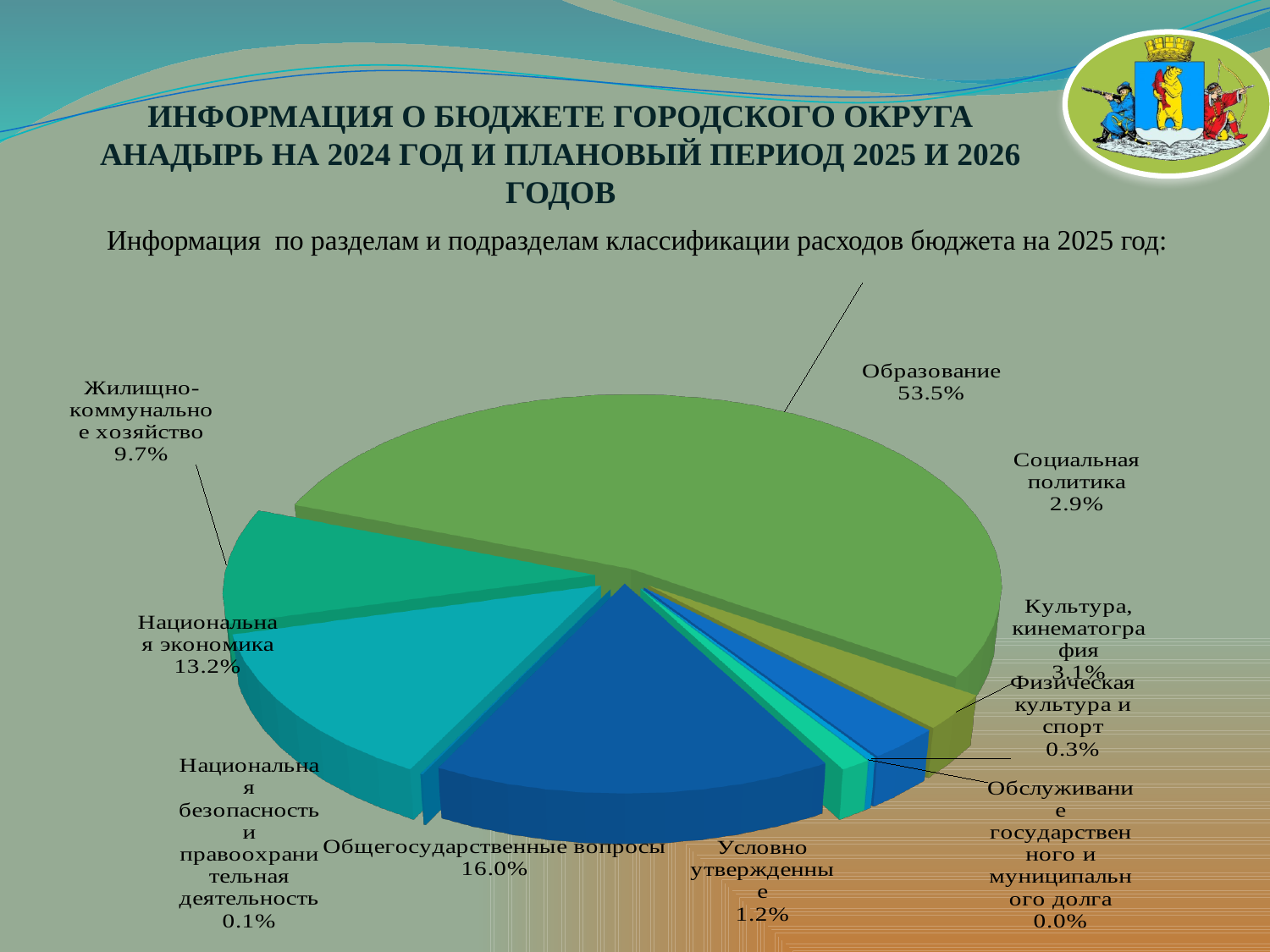
What is the difference in percentage points between Общегосударственные вопросы and Национальная экономика? 2.8 Which category has the smallest share of the pie? Обслуживание государственного и муниципального долга What percentage is shown for Национальная экономика? 13.2% How many categories are shown in the pie chart? 10 What percentage is shown for Жилищно-коммунальное хозяйство? 9.7% Which category has the largest share of the pie? Образование What percentage is shown for Общегосударственные вопросы? 16.0% Which is larger: the share for Культура, кинематография or the share for Социальная политика? Культура, кинематография What type of chart is shown on the slide? pie chart What is the combined share of Образование and Общегосударственные вопросы? 69.5% What percentage is shown for Условно утвержденные? 1.2% What share of the 2025 budget expenditures goes to Образование? 53.5%